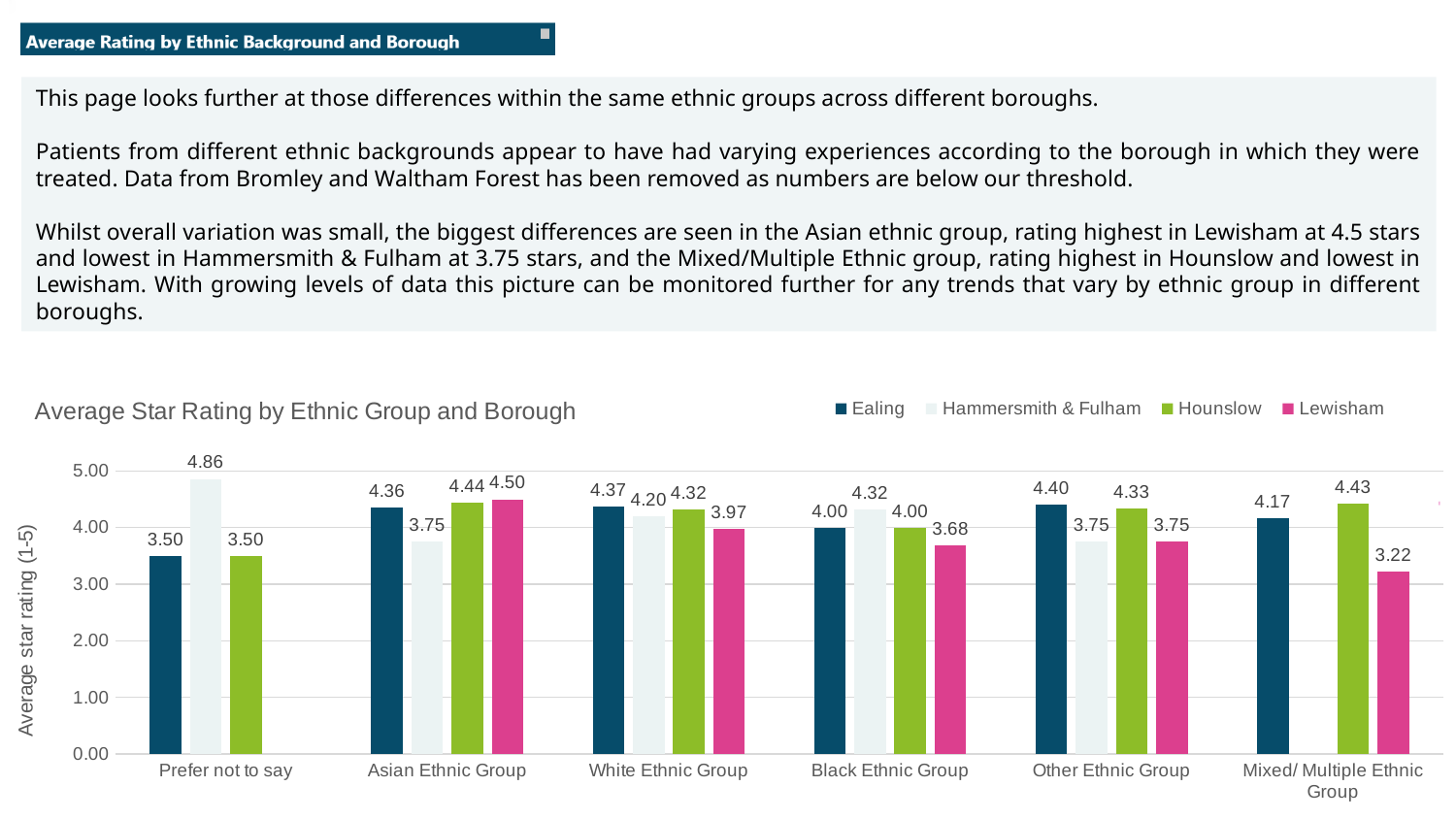
Which is higher: the Other Ethnic Group rating in Ealing or in Hounslow? Ealing What type of chart is used to show the average star ratings? Bar chart Which borough has the highest average star rating for the 'Prefer not to say' group? Hammersmith & Fulham What is the average star rating for the Black Ethnic Group in Hammersmith & Fulham? 4.32 What is the label of the y axis? Average star rating (1-5) What is the difference between the Asian Ethnic Group ratings in Lewisham and Hammersmith & Fulham? 0.75 How many ethnic group categories are shown on the x axis? 6 How many boroughs are listed in the legend? 4 What is the average star rating for the Asian Ethnic Group in Lewisham? 4.50 What is the average star rating for the Mixed/ Multiple Ethnic Group in Lewisham? 3.22 Is the Mixed/ Multiple Ethnic Group rating in Lewisham greater or less than 4.00? less Which borough has the lowest average star rating for the White Ethnic Group? Lewisham